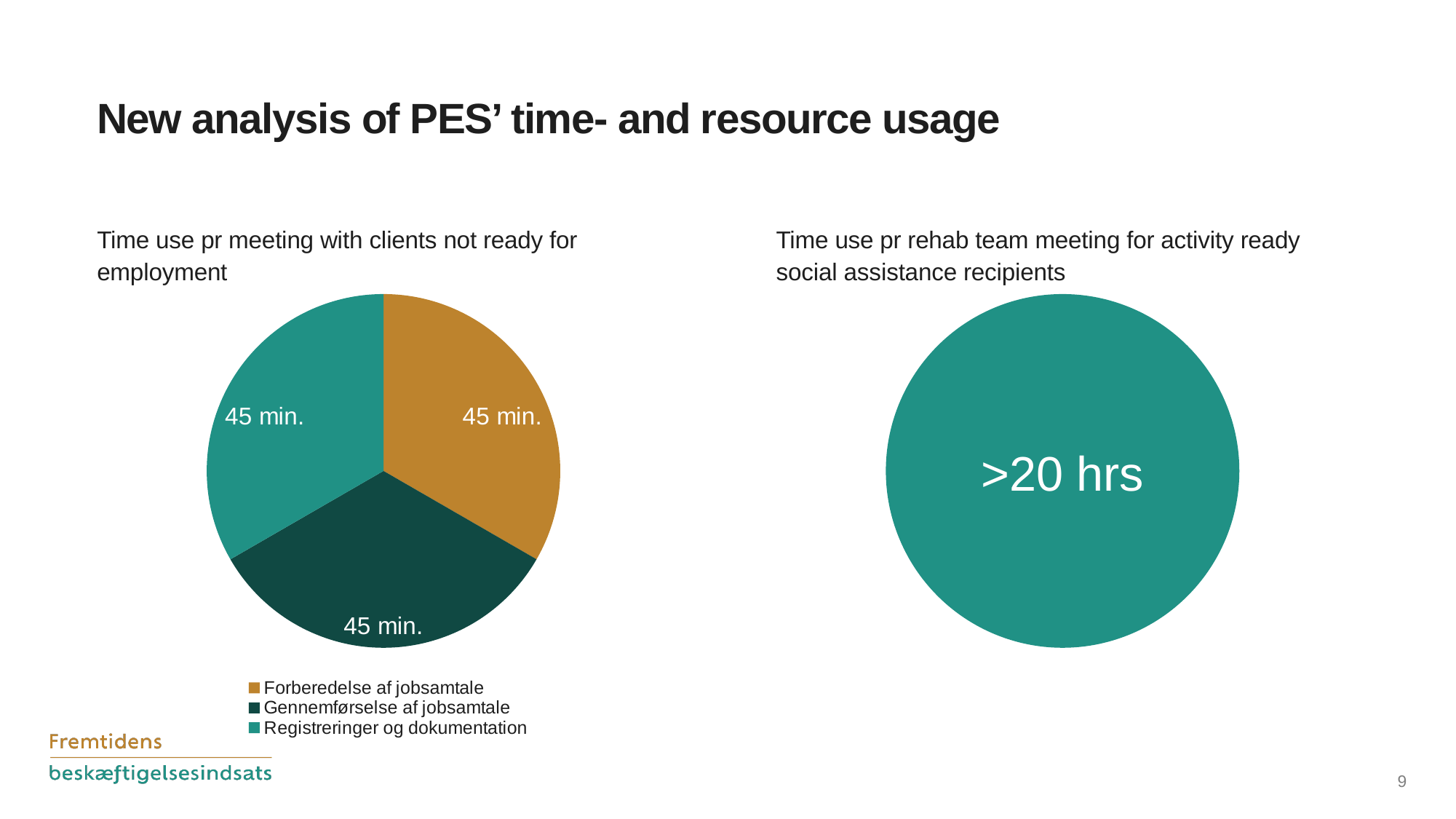
In the pie chart on the left, what is the value for Registreringer og dokumentation? 45 min. In the pie chart on the left, what share of the total does Registreringer og dokumentation represent? One third In the pie chart on the left, what is the value for Gennemførselse af jobsamtale? 45 min. How many slices does the pie chart on the left have? 3 In the pie chart on the left, what is the difference between the values for Forberedelse af jobsamtale and Gennemførselse af jobsamtale? 0 min. What kind of chart is shown on the left of the slide? Pie chart In the pie chart on the left, what is the value for Forberedelse af jobsamtale? 45 min. What value is shown in the circle on the right of the slide, for time use per rehab team meeting? >20 hrs How many entries does the legend of the pie chart on the left list? 3 What is the title above the pie chart on the left? Time use pr meeting with clients not ready for employment What colour is the Forberedelse af jobsamtale slice in the pie chart on the left? Gold/orange In the pie chart on the left, what is the total time across all three slices? 135 min.